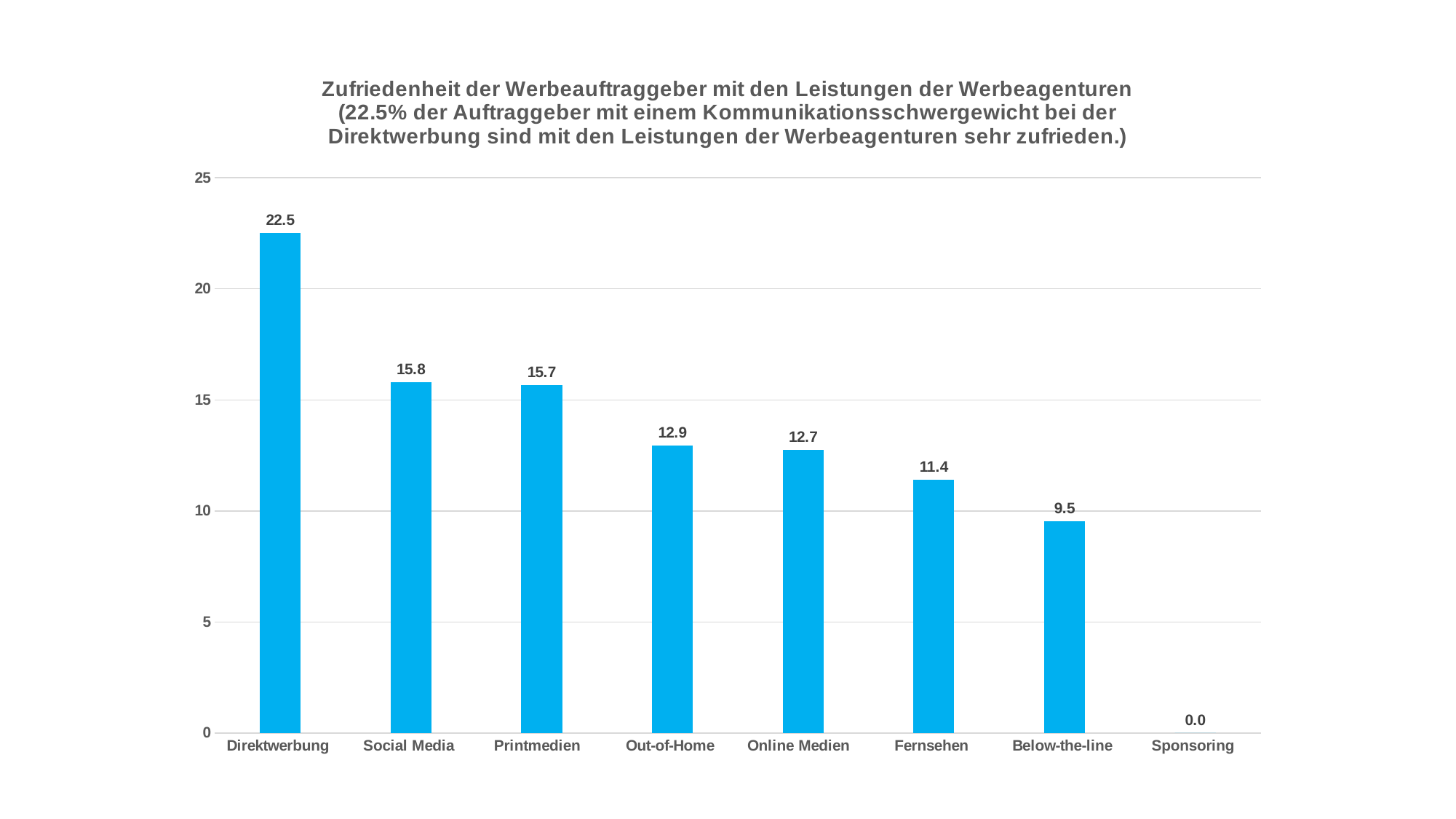
Which category has the highest value? Direktwerbung What is the value for Out-of-Home? 12.9 What is the difference between the values for Social Media and Online Medien? 3.1 What is the value for Below-the-line? 9.5 What is the difference between the values for Direktwerbung and Fernsehen? 11.1 Do the values rise or fall from left to right along the x axis? Fall What is the value for Sponsoring? 0.0 Which is larger, the value for Out-of-Home or the value for Fernsehen? Out-of-Home Which category has the lowest value? Sponsoring How many categories are shown on the x axis? 8 What is the value for Direktwerbung? 22.5 What kind of chart is shown on the slide? Bar chart